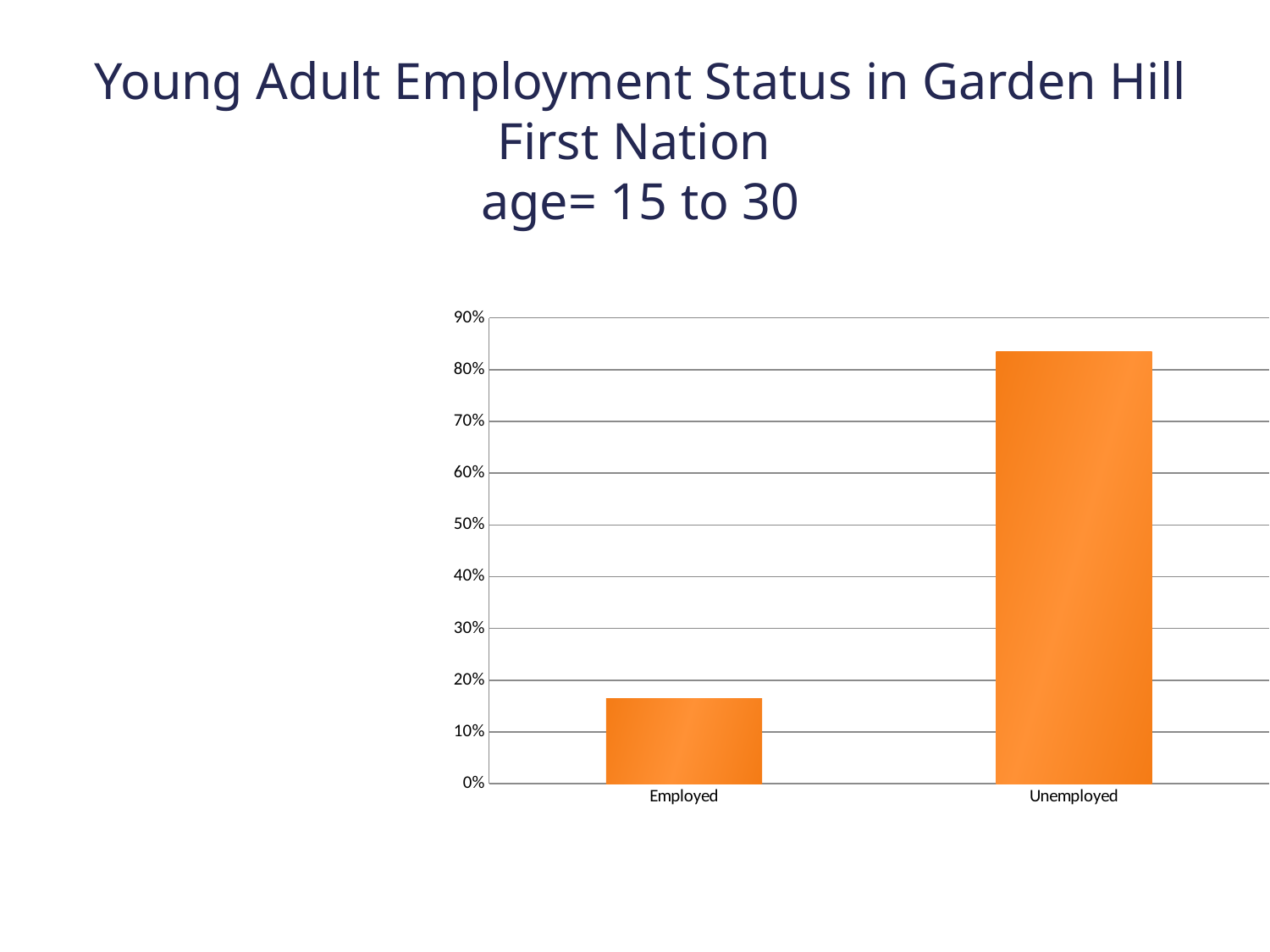
What kind of chart is shown on the slide? bar chart Is the value for Employed greater or less than 20%? less What age range does the slide title say the chart covers? 15 to 30 Which category has the lowest value? Employed How many categories are plotted on the x axis? 2 Is the value for Unemployed greater or less than 90%? less Which category has the highest value? Unemployed What is the highest value shown on the y axis? 90% Is the value for Employed greater or less than 10%? greater Which is larger, the value for Employed or the value for Unemployed? Unemployed